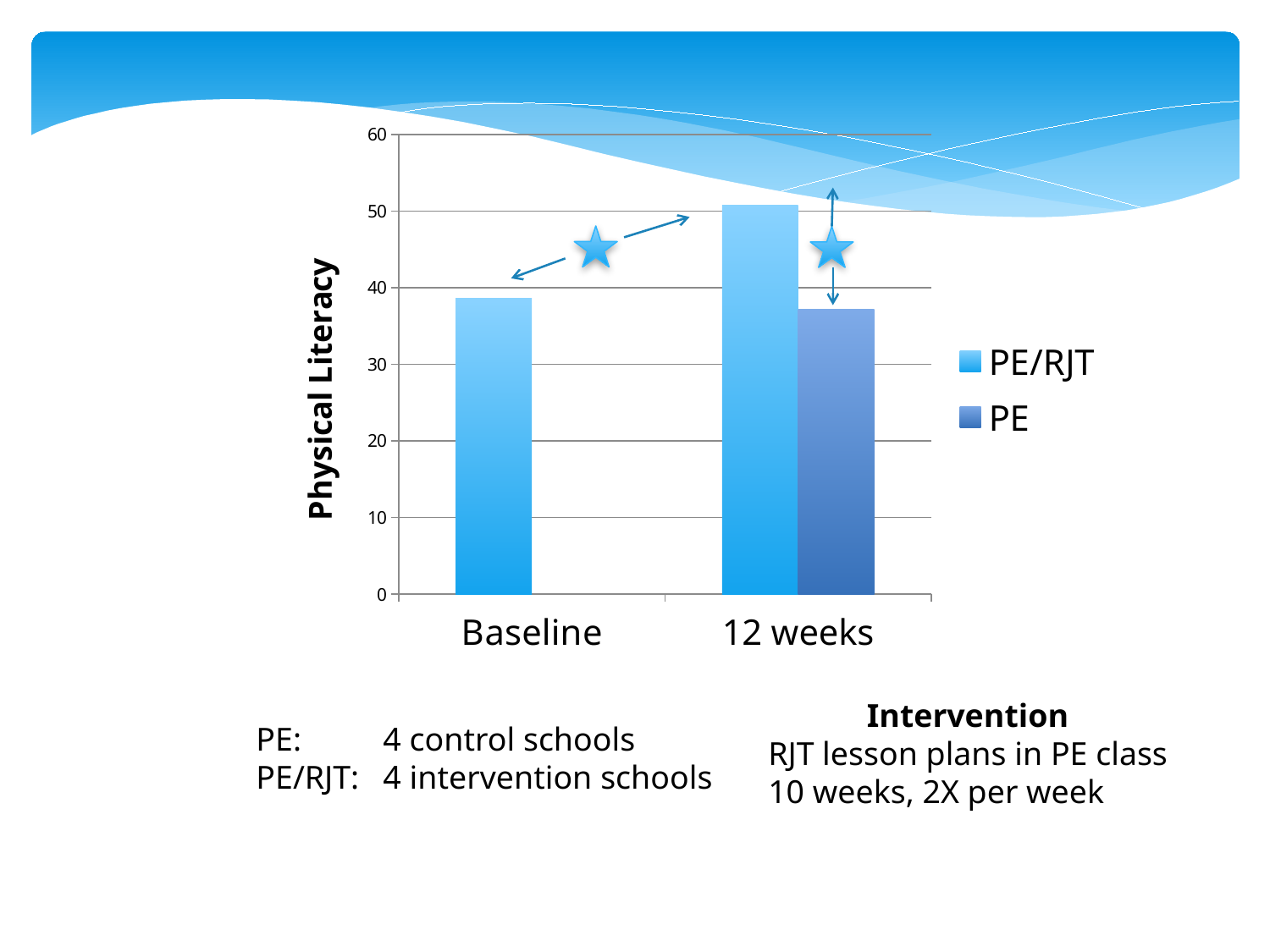
Does the PE/RJT value rise or fall from Baseline to 12 weeks? rise Is the value for PE/RJT at Baseline greater or less than 40? less What kind of chart is shown on the slide? bar chart Is the value for PE at 12 weeks greater or less than 40? less How many categories are shown on the x axis of the chart? 2 Is the value for PE at 12 weeks greater or less than 30? greater Which series are listed in the chart's legend? PE/RJT and PE What is the label of the vertical axis of the chart? Physical Literacy At 12 weeks, which series has the larger value, PE/RJT or PE? PE/RJT Which bar in the chart is the highest? PE/RJT at 12 weeks How many series does the chart's legend list? 2